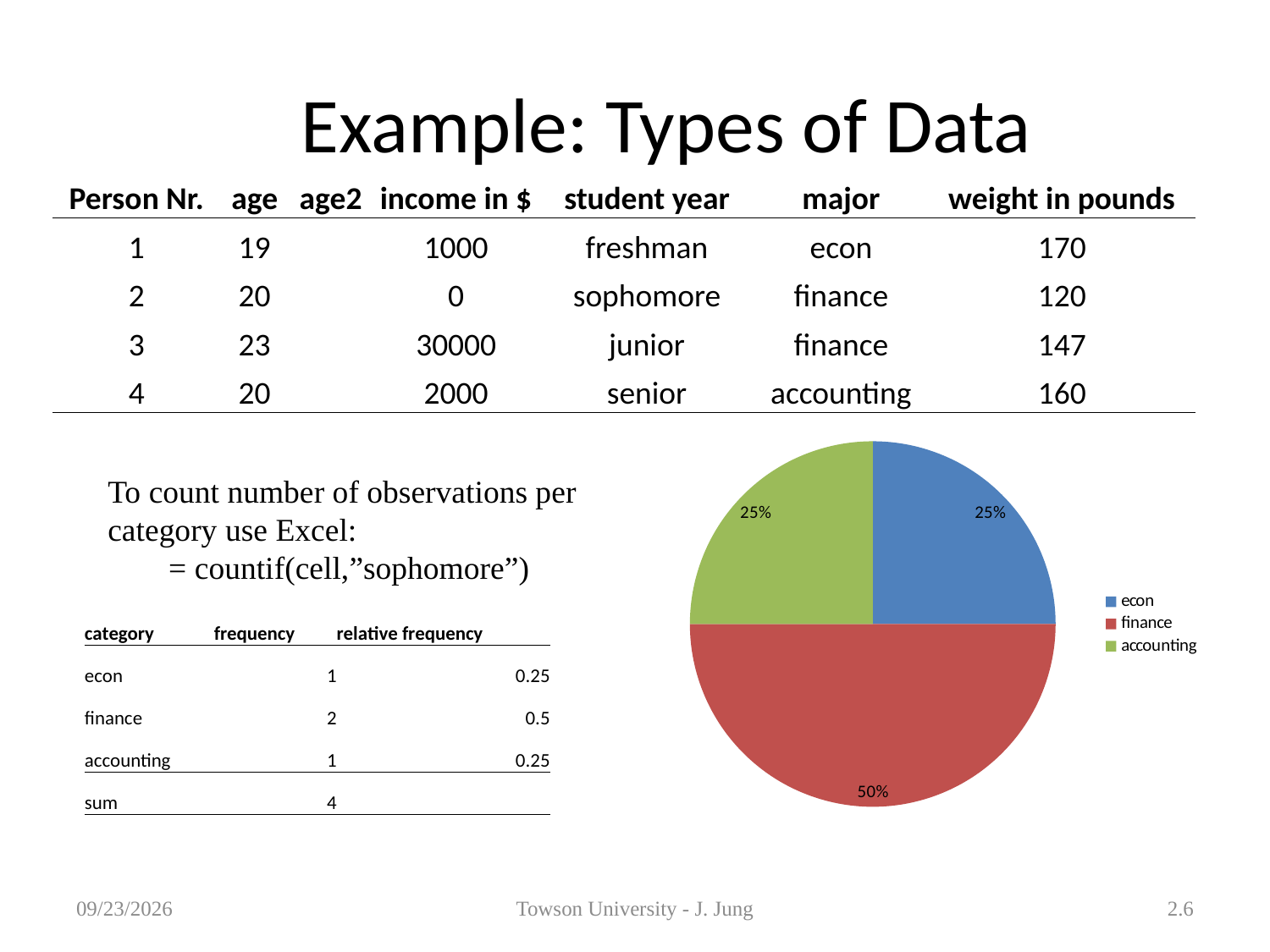
What kind of chart is shown on the slide? pie chart How many slices does the pie chart have? 3 Which is larger, the slice for finance or the slice for econ? finance What is the difference in percentage points between the finance slice and the accounting slice? 25 What share of the pie does econ have? 25% What share of the pie does finance have? 50% How many entries does the legend list? 3 What share of the pie does accounting have? 25% What colour is the finance slice in the pie chart? red Which legend entry is listed first? econ Which category has the largest slice of the pie? finance